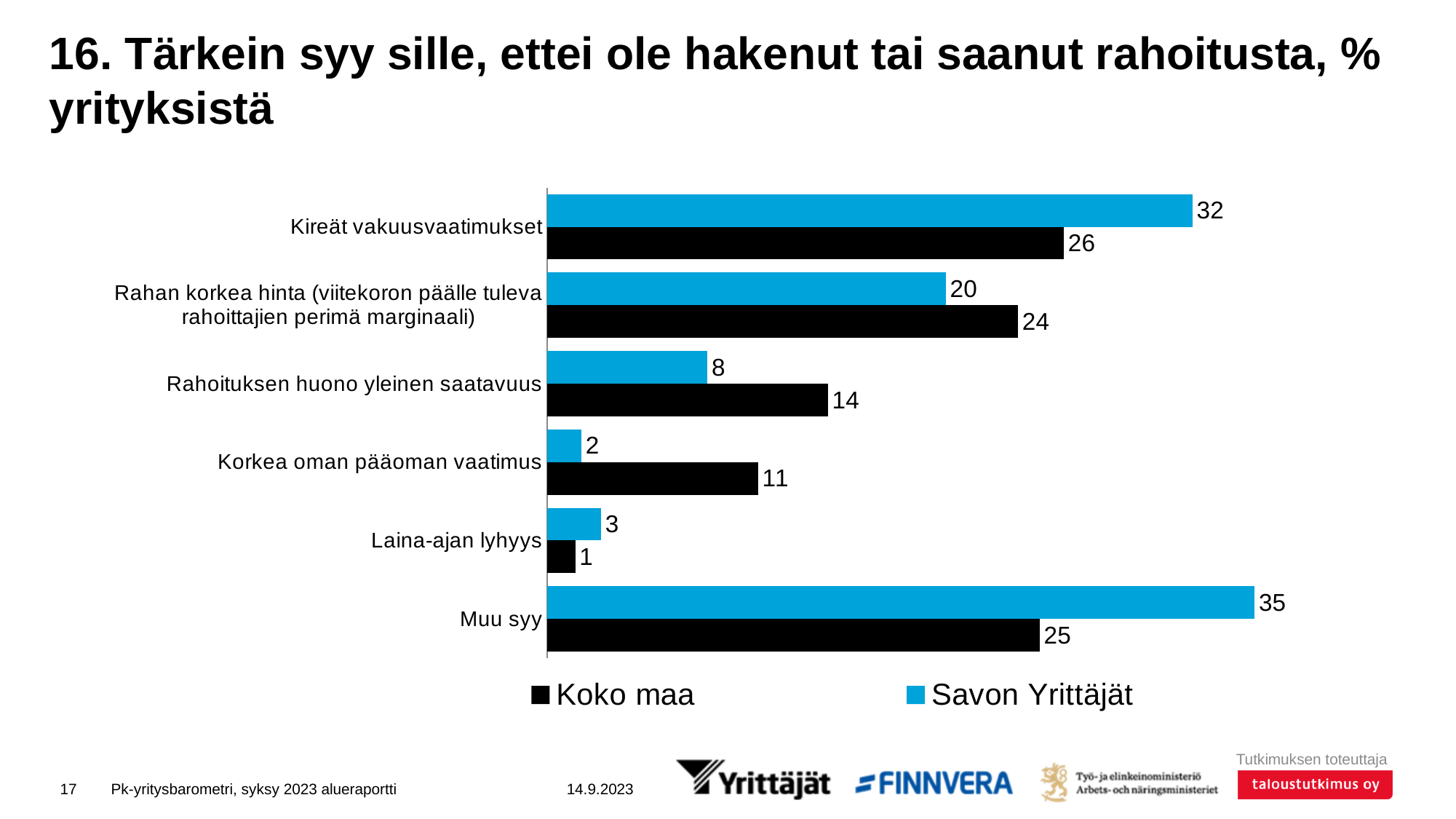
Which colour represents Savon Yrittäjät in the legend? Blue For Rahan korkea hinta, which series has the larger value, Koko maa or Savon Yrittäjät? Koko maa Which category has the lowest value for Koko maa? Laina-ajan lyhyys What is the difference between Savon Yrittäjät and Koko maa for Muu syy? 10 What kind of chart is shown on the slide? Bar chart What is the difference between Savon Yrittäjät and Koko maa for Korkea oman pääoman vaatimus? 9 Which category has the highest value for Savon Yrittäjät? Muu syy What is the value for Koko maa for Rahoituksen huono yleinen saatavuus? 14 How many series does the legend list? 2 How many categories are shown on the chart? 6 What is the value for Koko maa for Laina-ajan lyhyys? 1 What is the value for Savon Yrittäjät for Kireät vakuusvaatimukset? 32